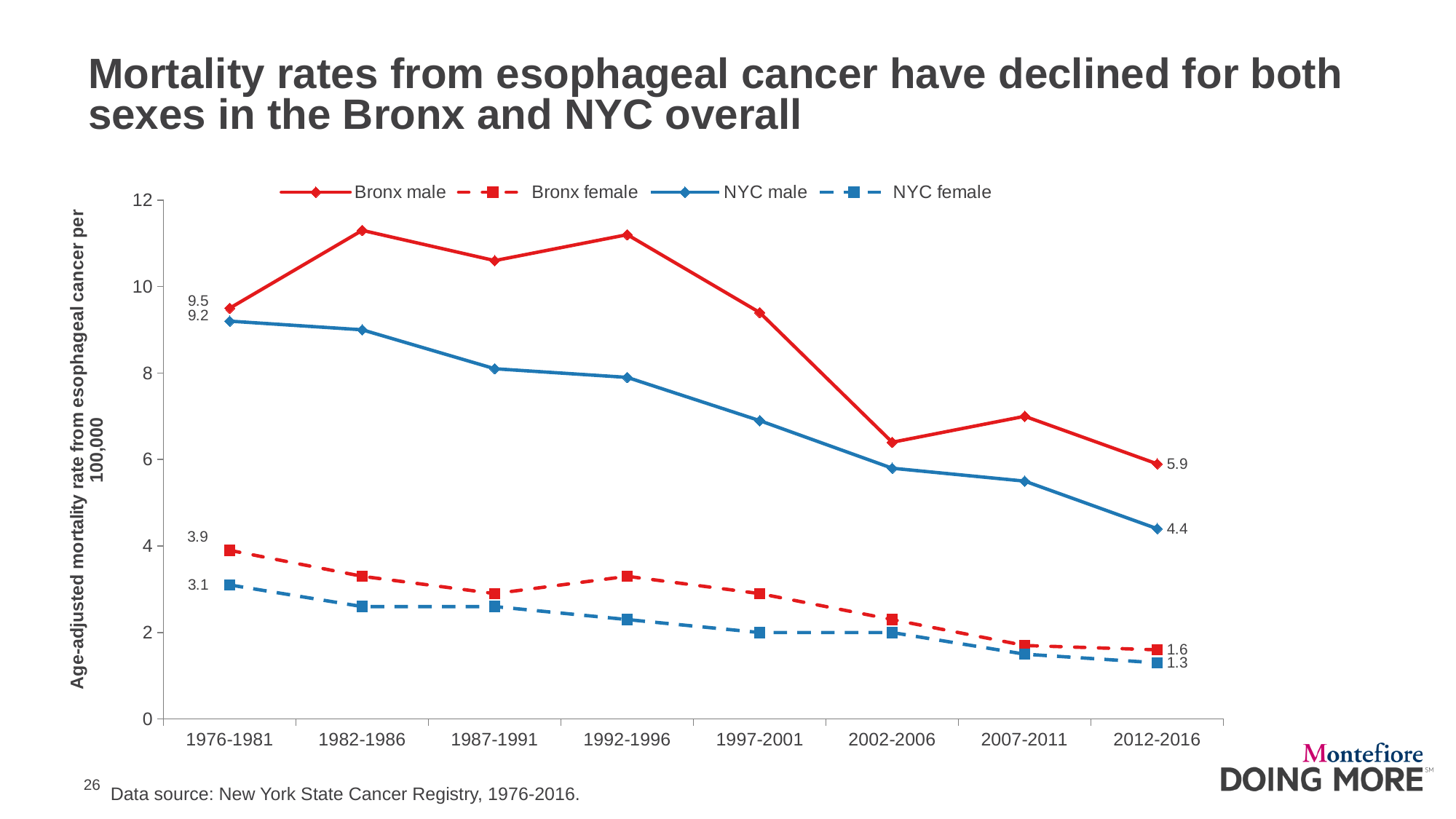
What is the NYC female mortality rate for 2012-2016? 1.3 What is the difference between the Bronx female and NYC female rates in 2012-2016? 0.3 What kind of chart is shown on the slide? Line chart What is the NYC male mortality rate for 2012-2016? 4.4 How many series does the legend list? 4 What is the Bronx male mortality rate for 1976-1981? 9.5 By how much did the Bronx male mortality rate fall from 1976-1981 to 2012-2016? 3.6 Which series has the highest value in 2012-2016? Bronx male Is the Bronx male rate for 1982-1986 greater or less than 10? greater Which series has the lowest value in 1976-1981? NYC female What is the Bronx female mortality rate for 1976-1981? 3.9 How many time periods are shown on the x axis? 8